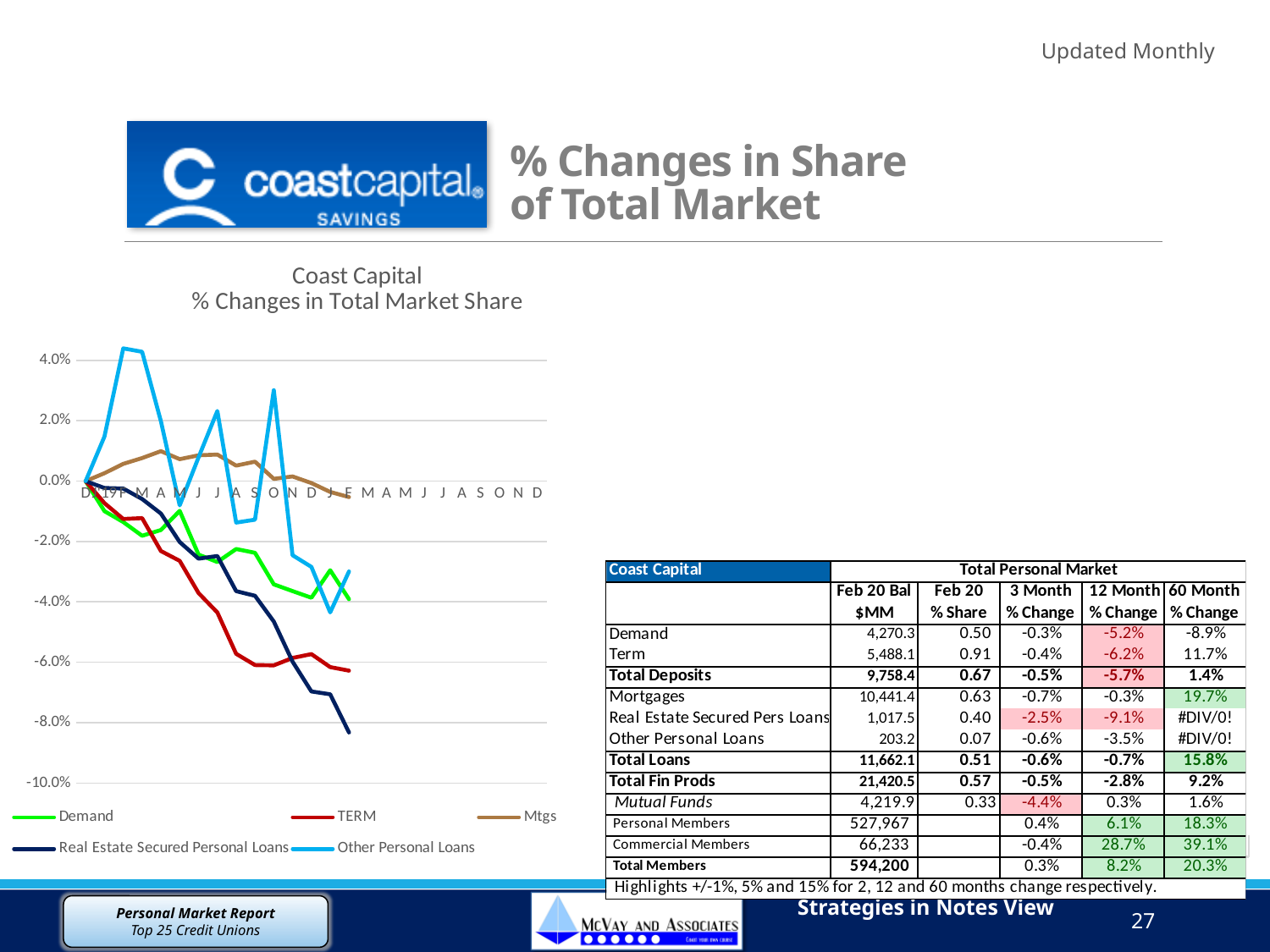
Is the final plotted value for Real Estate Secured Personal Loans greater or less than -6.0%? less Which series reaches the highest value on the chart? Other Personal Loans Which series reaches the lowest value on the chart? Real Estate Secured Personal Loans Is the lowest value of the TERM line greater or less than -4.0%? less Does the Real Estate Secured Personal Loans line rise or fall along the x axis? fall At the last plotted point, which is higher: Mtgs or Demand? Mtgs Is the peak value of the Other Personal Loans line greater or less than 2.0%? greater How many series does the legend of the chart list? 5 What is the title of the chart? Coast Capital % Changes in Total Market Share What colour is the Demand line in the chart? green Does the Demand line generally rise or fall along the x axis? fall What type of chart is shown on the slide? line chart